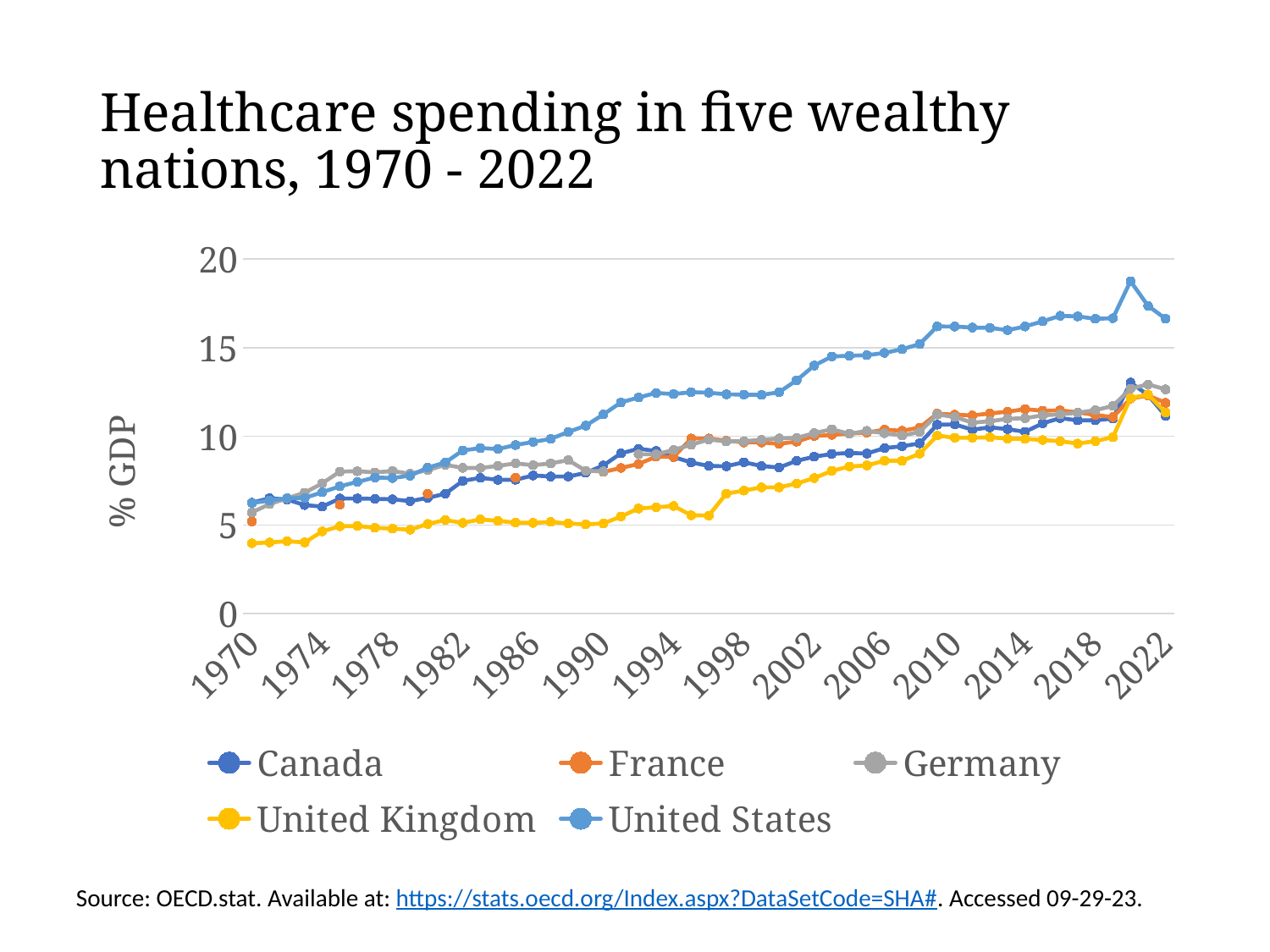
Does the United States line generally rise or fall from 1970 to 2022? rise Which country has the lowest healthcare spending as a share of GDP in 1970? United Kingdom Is the value for the United States in 2022 greater or less than 15? greater Is the value for the United States in 2020 greater or less than 15? greater Which is larger in 2010, the value for the United States or the value for the United Kingdom? United States Is the value for the United Kingdom in 1990 greater or less than 10? less Which is larger in 1980, the value for Germany or the value for the United Kingdom? Germany What kind of chart is shown on the slide? line chart What is the label on the vertical axis of the chart? % GDP Which country has the highest healthcare spending as a share of GDP in 2022? United States How many series does the legend list? 5